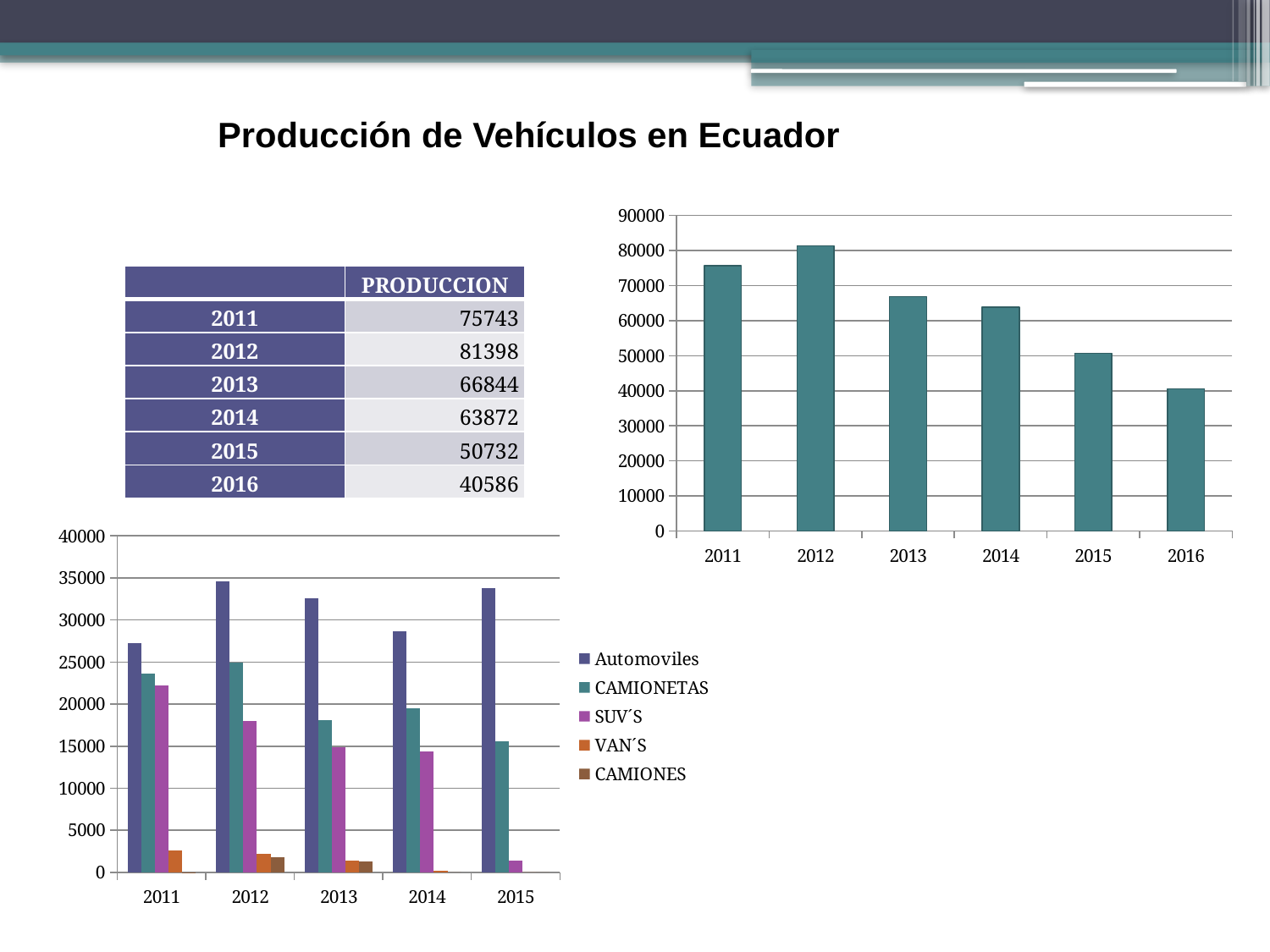
In the bar chart at the bottom left of the slide, how many series does the legend list? 5 In the bar chart at the top right of the slide, which year has the highest production? 2012 In the bar chart at the top right of the slide, which year has the lowest production? 2016 In the bar chart at the bottom left of the slide, which series is shown in purple/magenta? SUV´S In the bar chart at the top right of the slide, how many years are shown on the x axis? 6 In the bar chart at the bottom left of the slide, which is larger in 2014: Automoviles or SUV´S? Automoviles In the bar chart at the top right of the slide, what is the difference in production between 2011 and 2016? 35157 In the bar chart at the top right of the slide, do the values rise or fall from 2012 to 2016? fall In the bar chart at the top right of the slide, what is the production value for 2012? 81398 What kind of chart is shown at the bottom left of the slide? bar chart In the bar chart at the bottom left of the slide, is the value for Automoviles in 2012 greater or less than 30000? greater In the bar chart at the bottom left of the slide, is the value for CAMIONETAS in 2015 greater or less than 20000? less